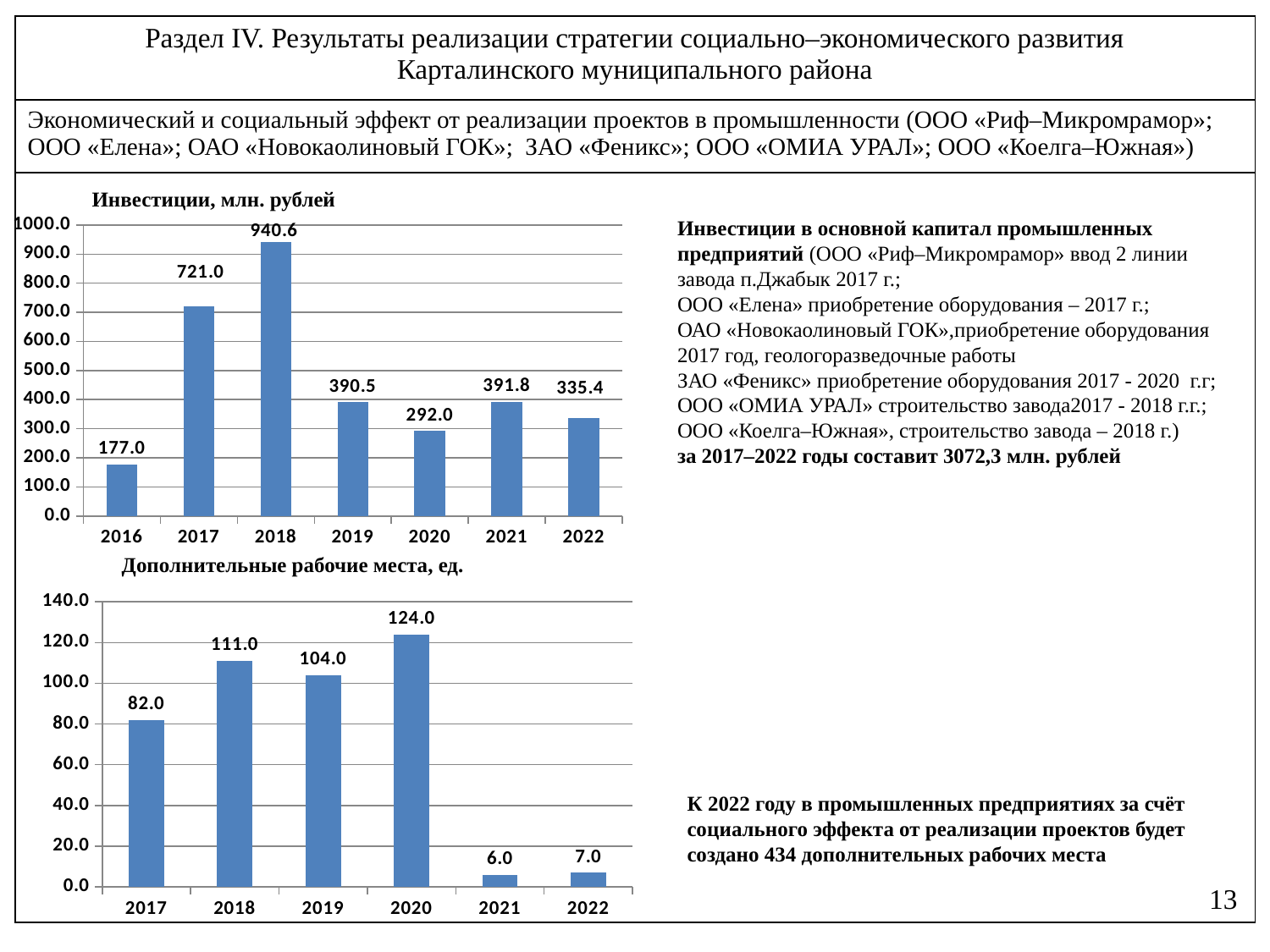
In the chart titled "Инвестиции, млн. рублей", what is the value for 2022? 335.4 In the chart titled "Дополнительные рабочие места, ед.", what is the value for 2020? 124.0 In the chart titled "Инвестиции, млн. рублей", what is the difference between the values for 2017 and 2016? 544.0 In the chart titled "Инвестиции, млн. рублей", which year has the lowest value? 2016 In the chart titled "Дополнительные рабочие места, ед.", how many years are shown on the x axis? 6 In the chart titled "Инвестиции, млн. рублей", what is the value for 2018? 940.6 In the chart titled "Дополнительные рабочие места, ед.", which year has the lowest value? 2021 In the chart titled "Дополнительные рабочие места, ед.", which year has the highest value? 2020 In the chart titled "Инвестиции, млн. рублей", which is larger, the value for 2019 or the value for 2020? 2019 What type of chart is the chart titled "Дополнительные рабочие места, ед."? Bar chart In the chart titled "Инвестиции, млн. рублей", how many years are shown on the x axis? 7 In the chart titled "Дополнительные рабочие места, ед.", what is the difference between the values for 2018 and 2019? 7.0